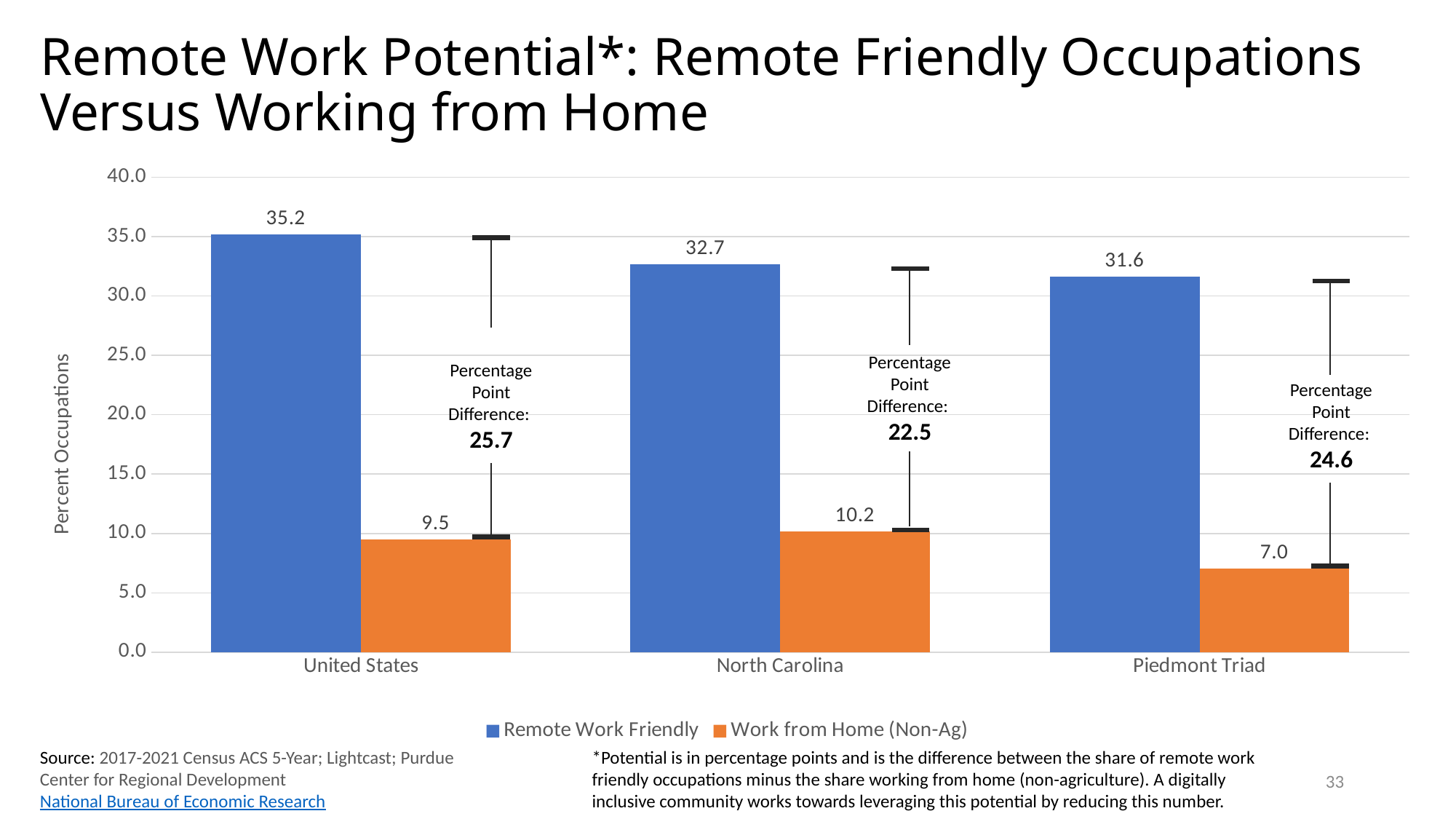
What is the Remote Work Friendly value for the United States? 35.2 What is the difference between the Remote Work Friendly and Work from Home (Non-Ag) values for North Carolina? 22.5 Which is larger, the Work from Home (Non-Ag) value for the United States or for North Carolina? North Carolina How many series does the legend list? 2 What is the Work from Home (Non-Ag) value for Piedmont Triad? 7.0 What is the difference between the Remote Work Friendly values for the United States and Piedmont Triad? 3.6 What kind of chart is shown on the slide? bar chart Which region has the lowest Work from Home (Non-Ag) value? Piedmont Triad Which region has the highest Remote Work Friendly value? United States What is the Work from Home (Non-Ag) value for North Carolina? 10.2 How many regions are shown on the x axis? 3 Is the Remote Work Friendly value for Piedmont Triad greater or less than 30.0? greater